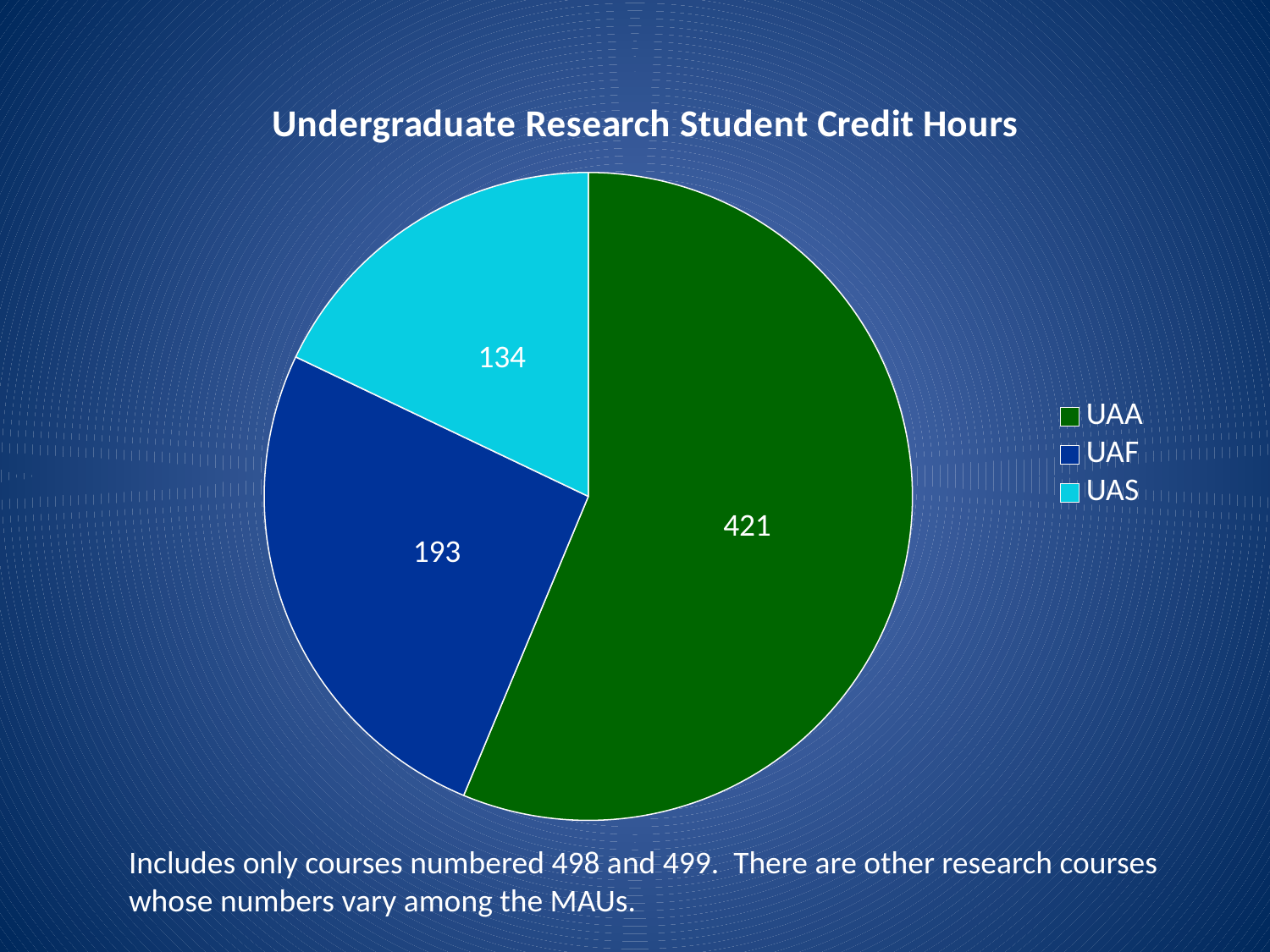
Which category has the largest slice of the pie chart? UAA How many slices does the pie chart have? 3 What is the difference between the values for UAA and UAF? 228 What is the value for UAA in the pie chart? 421 What type of chart is shown on the slide? Pie chart What is the value for UAF in the pie chart? 193 What is the value for UAS in the pie chart? 134 What is the total of all the slices in the pie chart? 748 Which is larger, the value for UAF or the value for UAS? UAF What is the title of the chart? Undergraduate Research Student Credit Hours Which category has the smallest slice of the pie chart? UAS What is the difference between the values for UAF and UAS? 59